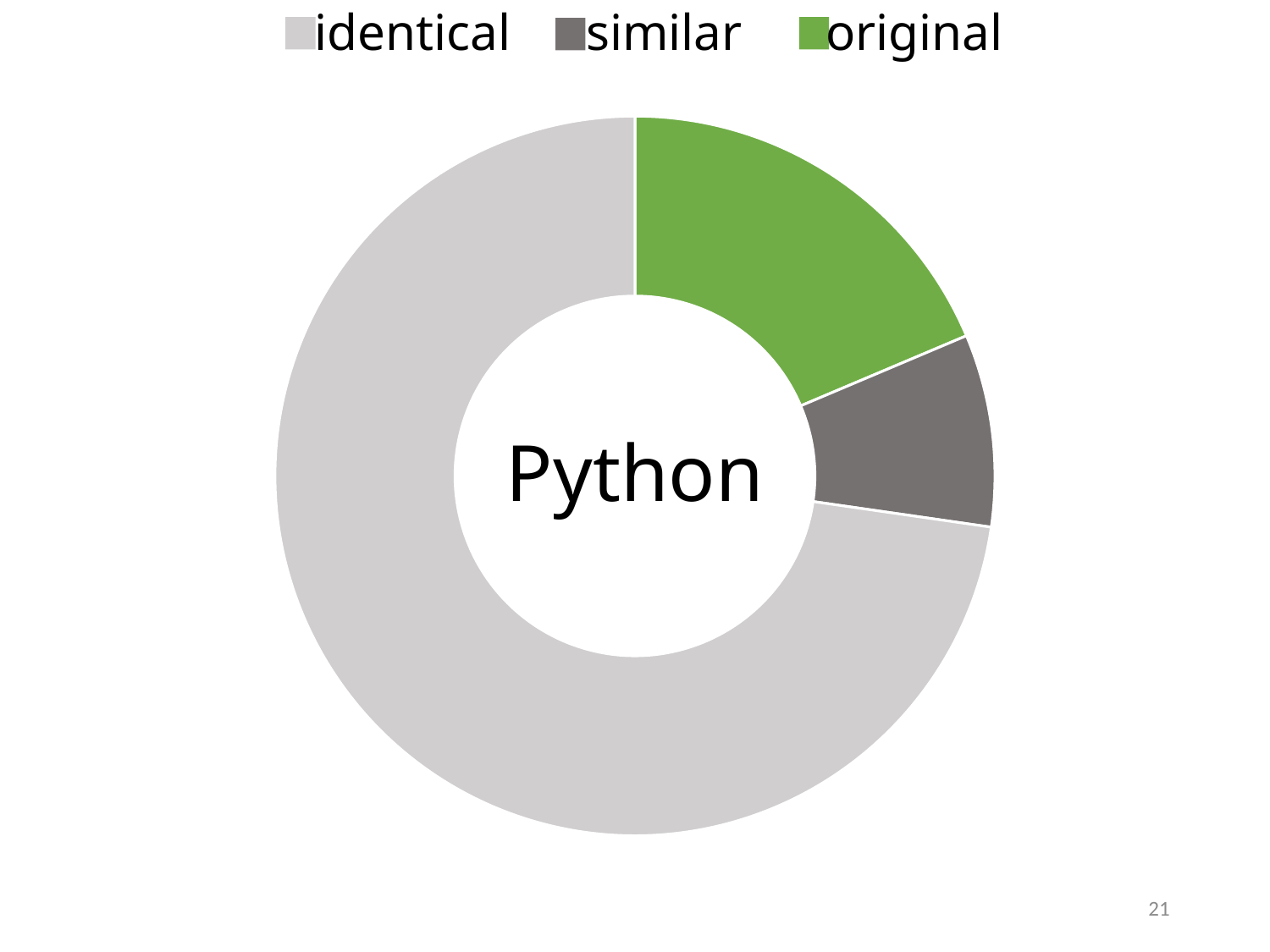
Which is larger, the share for original or the share for similar? original What text is shown in the centre of the doughnut chart? Python How many categories does the chart show? 3 Which is larger, the share for similar or the share for identical? identical Which category has the largest share of the chart? identical What kind of chart is shown on the slide? doughnut chart What colour is the original segment of the chart? green Which is larger, the share for identical or the share for original? identical Which category has the smallest share of the chart? similar